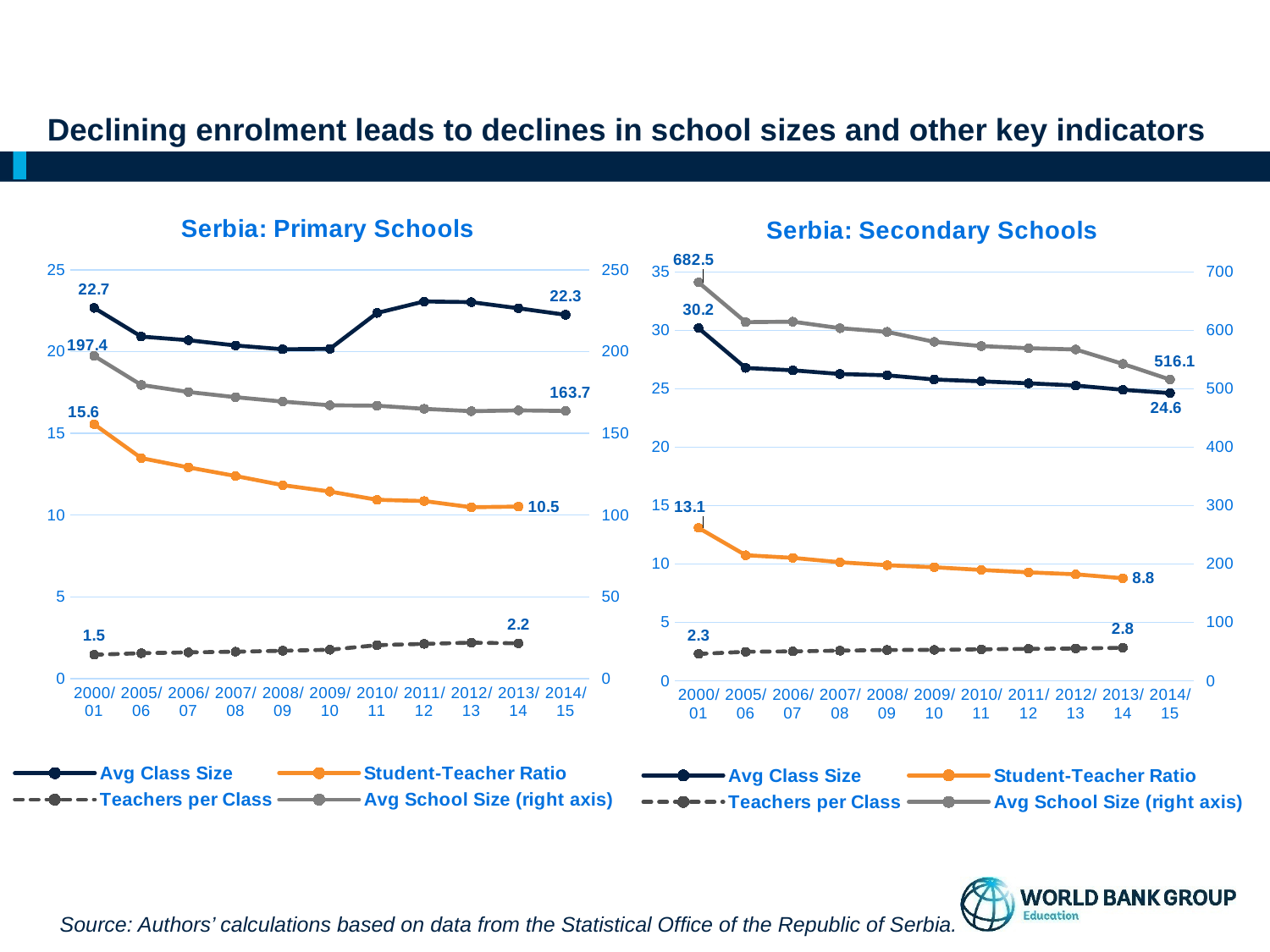
In the Serbia: Primary Schools chart, does the Teachers per Class line rise or fall from 2000/01 to 2013/14? rise In the Serbia: Secondary Schools chart, by how much did the Avg Class Size fall from 2000/01 (30.2) to 2014/15 (24.6)? 5.6 In the Serbia: Primary Schools chart, what is the Avg Class Size in 2000/01? 22.7 What kind of chart is the Serbia: Primary Schools chart? line chart In the Serbia: Secondary Schools chart, does the Avg School Size rise or fall over the period shown? fall In the Serbia: Secondary Schools chart, what is the Student-Teacher Ratio in 2013/14? 8.8 In the Serbia: Secondary Schools chart, what is the Avg School Size in 2000/01? 682.5 How many series does the legend of the Serbia: Secondary Schools chart list? 4 In the Serbia: Primary Schools chart, what is the difference between the Student-Teacher Ratio in 2000/01 (15.6) and in 2013/14 (10.5)? 5.1 In the Serbia: Secondary Schools chart, is the Avg Class Size in 2005/06 greater or less than 25? greater In the Serbia: Primary Schools chart, what is the Avg School Size in 2014/15? 163.7 How many school years are shown on the x axis of the Serbia: Primary Schools chart? 11